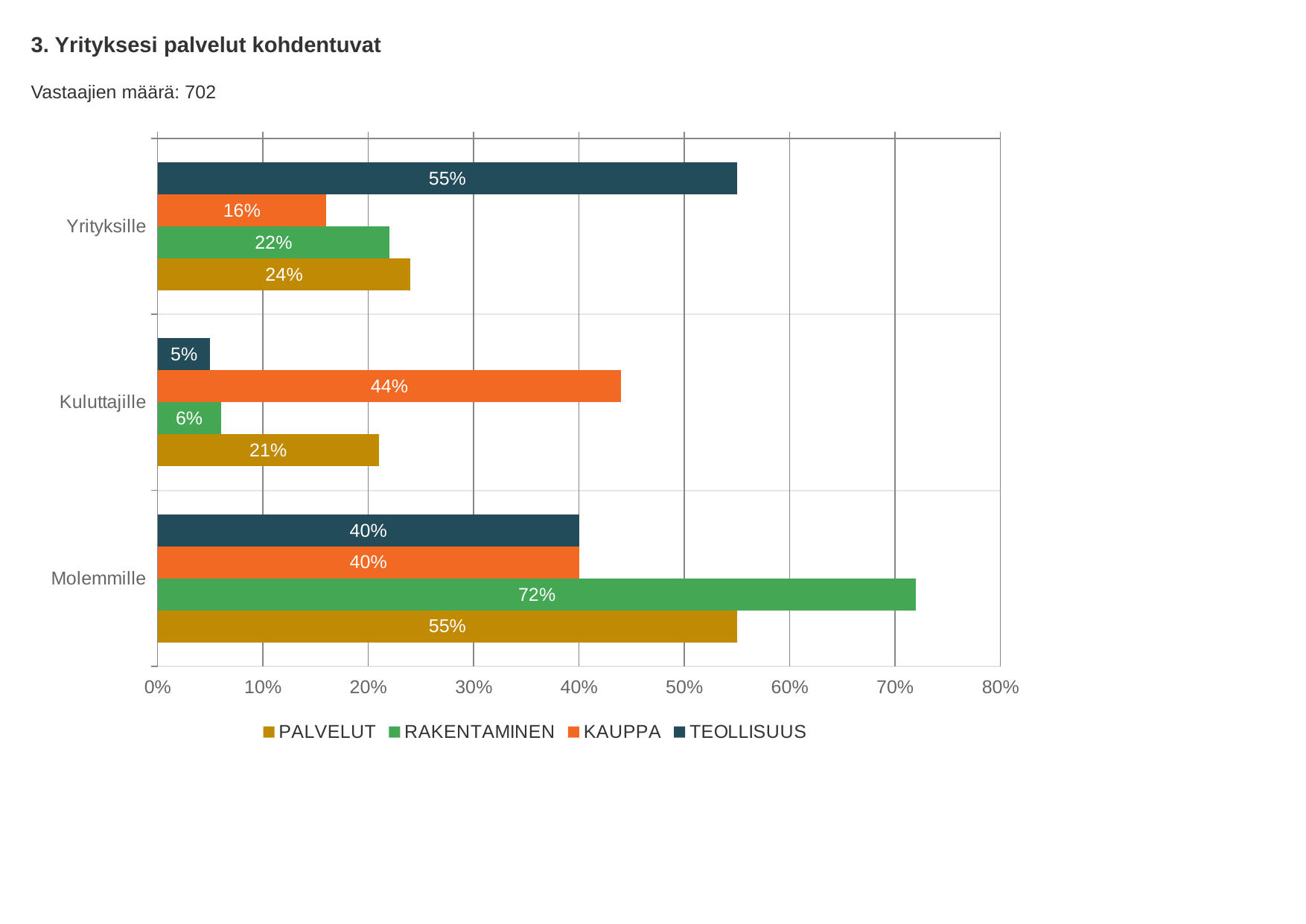
Which series has the lowest value in the Kuluttajille category? TEOLLISUUS What kind of chart is shown on the slide? Bar chart How many series does the legend list? 4 Which is larger in the Yrityksille category: PALVELUT or KAUPPA? PALVELUT How many categories are shown on the vertical axis? 3 What is the difference between the RAKENTAMINEN and PALVELUT values in the Molemmille category? 17% What is the value for KAUPPA in the Kuluttajille category? 44% What is the value for TEOLLISUUS in the Yrityksille category? 55% What is the value for PALVELUT in the Kuluttajille category? 21% What is the number of respondents (Vastaajien määrä) stated on the slide? 702 What is the value for RAKENTAMINEN in the Molemmille category? 72% Which series has the highest value in the Molemmille category? RAKENTAMINEN